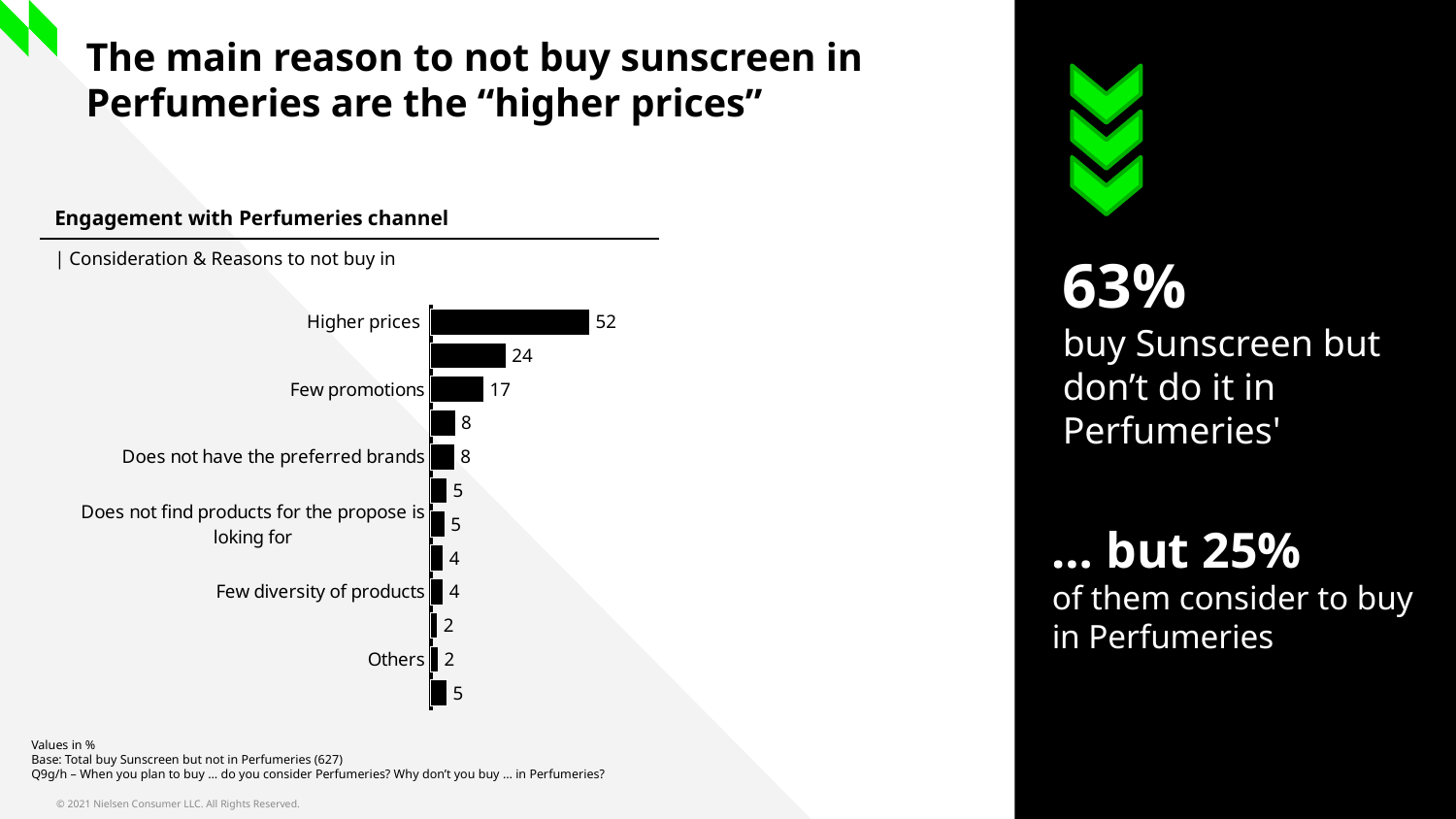
What kind of chart is shown on the slide? Bar chart What is the value for "Few diversity of products"? 4 What is the difference between the values for "Higher prices" and "Few promotions"? 35 Which labelled reason has the highest value? Higher prices How many bars are plotted in the chart? 12 Which is larger, the value for "Few promotions" or the value for "Does not have the preferred brands"? Few promotions What is the value for "Higher prices"? 52 What is the difference between the values for "Does not have the preferred brands" and "Few diversity of products"? 4 What is the value for "Others"? 2 What is the value for "Few promotions"? 17 What is the title of the chart section on the slide? Engagement with Perfumeries channel What is the value for "Does not have the preferred brands"? 8